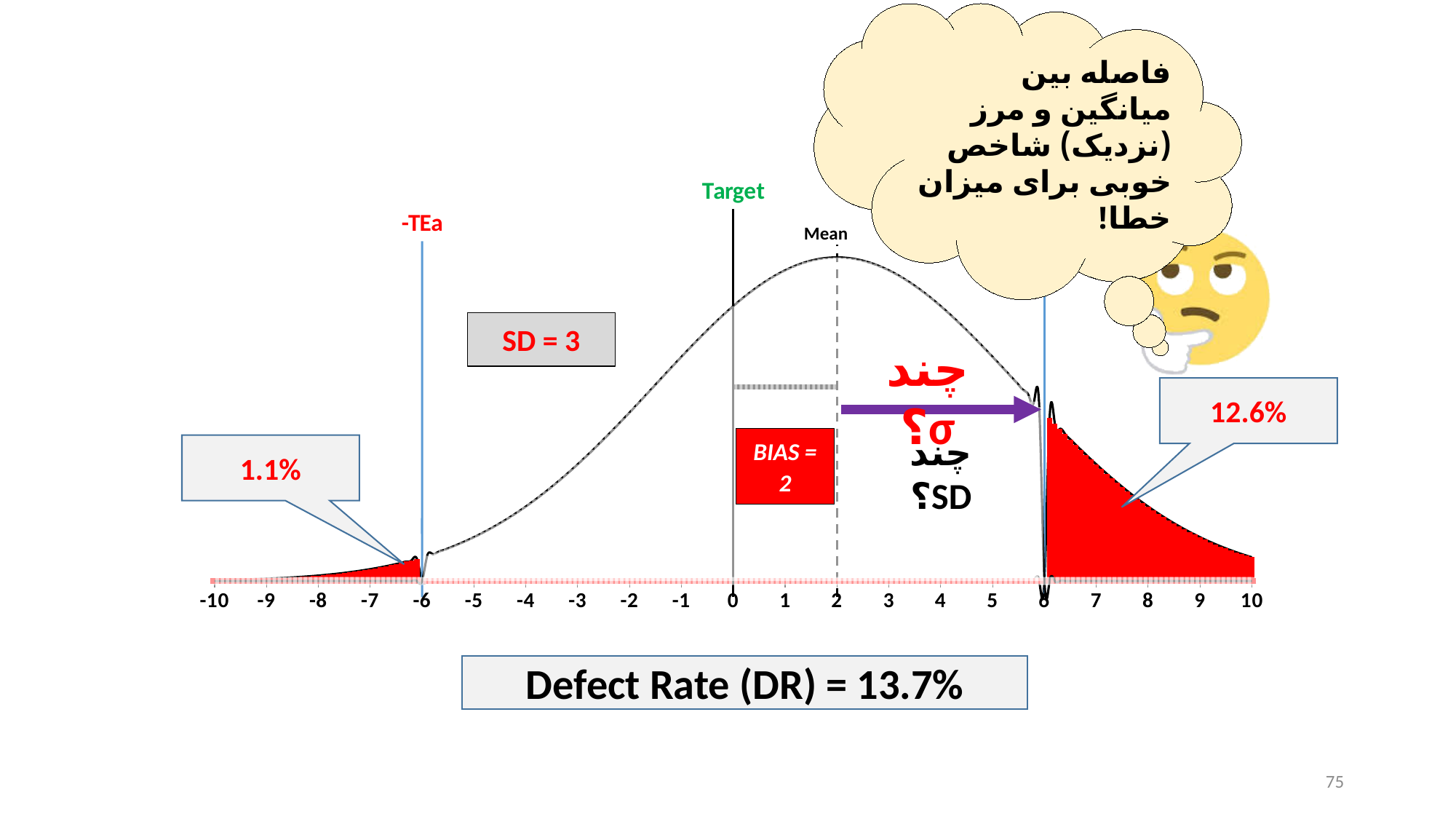
What is the range of the x axis on the chart? -10 to 10 At what x-axis value is the -TEa line located? -6 What is the BIAS value shown on the chart? 2 What is the SD value shown on the chart? 3 Which red shaded tail has the larger percentage, the left tail or the right tail? right tail What percentage is labeled for the red shaded area in the right tail of the curve? 12.6% What percentage is labeled for the red shaded area in the left tail of the curve? 1.1% What is the sum of the two red tail percentages, 1.1% and 12.6%? 13.7% What is the difference between the right tail percentage (12.6%) and the left tail percentage (1.1%)? 11.5% What is the Defect Rate (DR) stated below the chart? 13.7% At what x-axis value is the Mean dashed line located? 2 At what x-axis value is the Target line located? 0